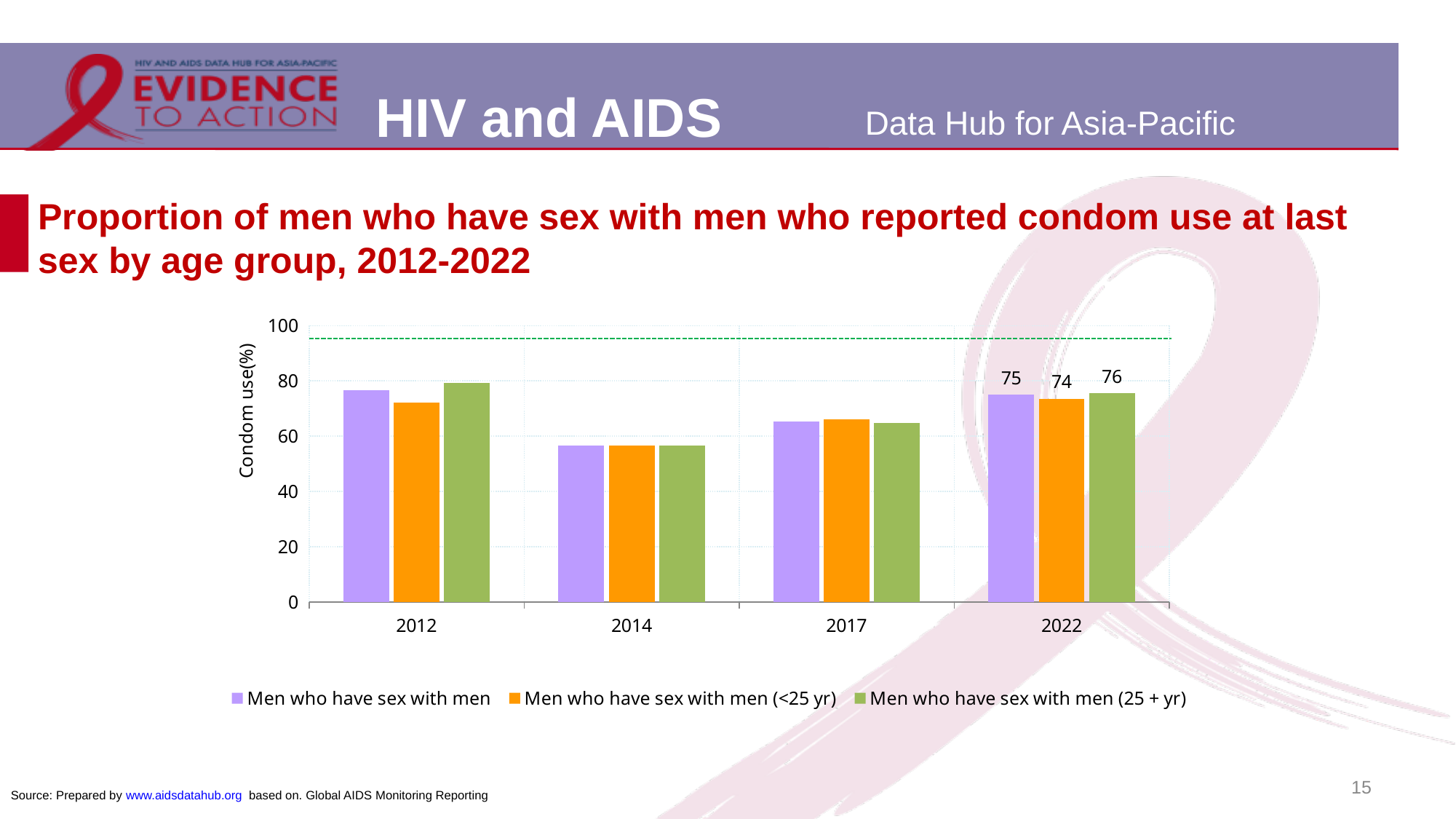
What is the value for Men who have sex with men in 2022? 75 What kind of chart is shown on the slide? bar chart How many series does the legend list? 3 In which year is the value for Men who have sex with men the lowest? 2014 What is the value for Men who have sex with men (<25 yr) in 2022? 74 Is the value for Men who have sex with men in 2014 greater or less than 60? less How many years are shown on the x axis? 4 In 2022, what is the difference between the values for Men who have sex with men (25 + yr) and Men who have sex with men (<25 yr)? 2 In 2022, which is larger: the value for Men who have sex with men (25 + yr) or Men who have sex with men (<25 yr)? Men who have sex with men (25 + yr) Is the value for Men who have sex with men (25 + yr) in 2012 greater or less than 60? greater What is the label of the y axis? Condom use(%) What is the value for Men who have sex with men (25 + yr) in 2022? 76